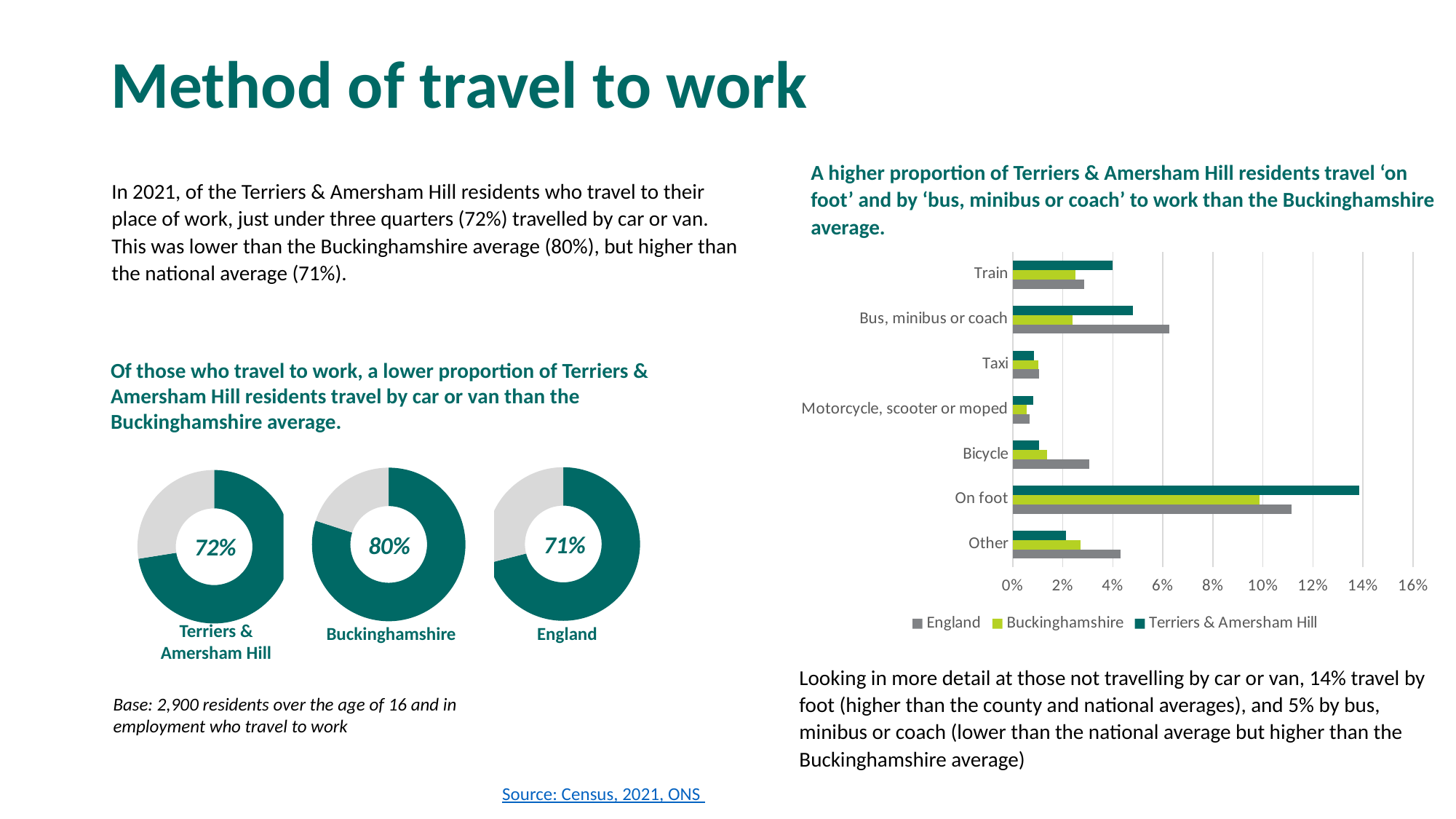
Among the three donut charts, which area has the lowest proportion travelling by car or van? England In the bar chart on the right, is the Terriers & Amersham Hill value for 'On foot' greater or less than 12%? greater In the bar chart on the right, which is larger for 'Bus, minibus or coach': the England value or the Terriers & Amersham Hill value? England In the donut charts, what is the difference between the Buckinghamshire value and the Terriers & Amersham Hill value? 8% Among the three donut charts, which area has the highest proportion travelling by car or van? Buckinghamshire In the bar chart on the right, how many series does the legend list? 3 In the bar chart on the right, how many travel method categories are shown? 7 In the donut charts, what percentage of Terriers & Amersham Hill residents who travel to work travelled by car or van? 72% In the bar chart on the right, which category has the longest bar for Terriers & Amersham Hill? On foot In the donut charts, what is the value shown for England? 71% In the donut charts, what is the value shown for Buckinghamshire? 80% What kind of chart is the chart on the right of the slide? Bar chart